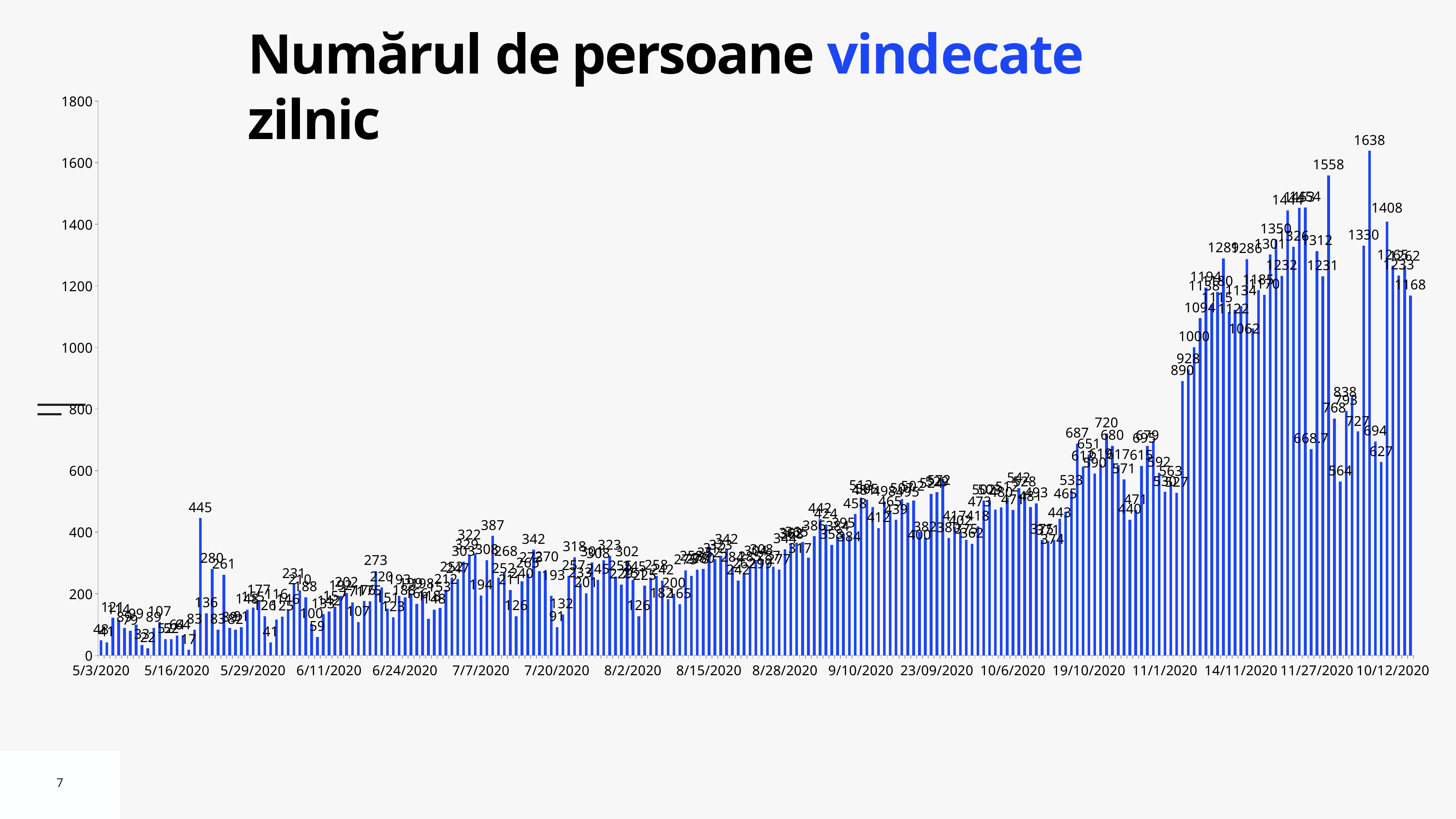
What is the title of the chart? Numărul de persoane vindecate zilnic What is the value of the rightmost bar in the chart? 1168 What is the value of the second-tallest bar in the chart? 1558 What kind of chart is shown on the slide? bar chart Do the values generally rise or fall from left to right along the x axis? rise Which is larger, the bar labelled 1638 or the bar labelled 1408? 1638 What is the value of the tallest bar between 5/16/2020 and 5/29/2020? 445 What is the highest value shown in the chart? 1638 Is the tallest bar in the chart greater or less than 1600? greater What is the value of the tallest bar between 7/7/2020 and 7/20/2020? 387 What colour are the bars in the chart? blue What is the difference between the two tallest bars, labelled 1638 and 1558? 80